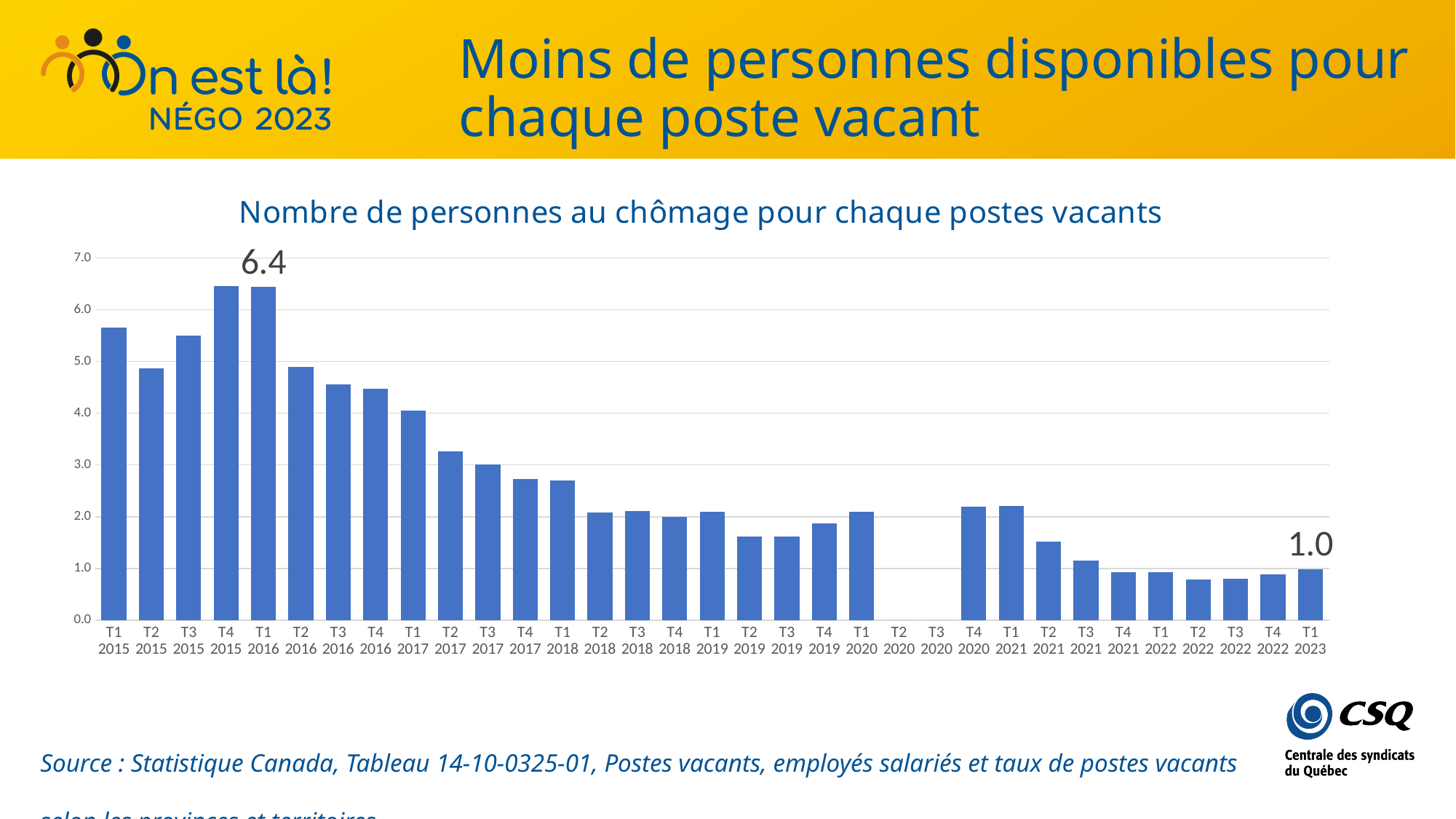
Is the value for T1 2015 greater or less than 5.0? greater Which is larger, the value for T1 2015 or the value for T1 2023? T1 2015 What is the value for T1 2023? 1.0 What is the difference between the value for T1 2016 and the value for T1 2023? 5.4 What is the value for T1 2016? 6.4 What is the title of the chart? Nombre de personnes au chômage pour chaque postes vacants Which quarters on the x axis have no bar plotted? T2 2020 and T3 2020 Is the value for T2 2017 greater or less than 3.0? greater What kind of chart is shown on the slide? bar chart Is the value for T4 2020 greater or less than 2.0? greater Overall, do the values rise or fall from T1 2015 to T1 2023? fall